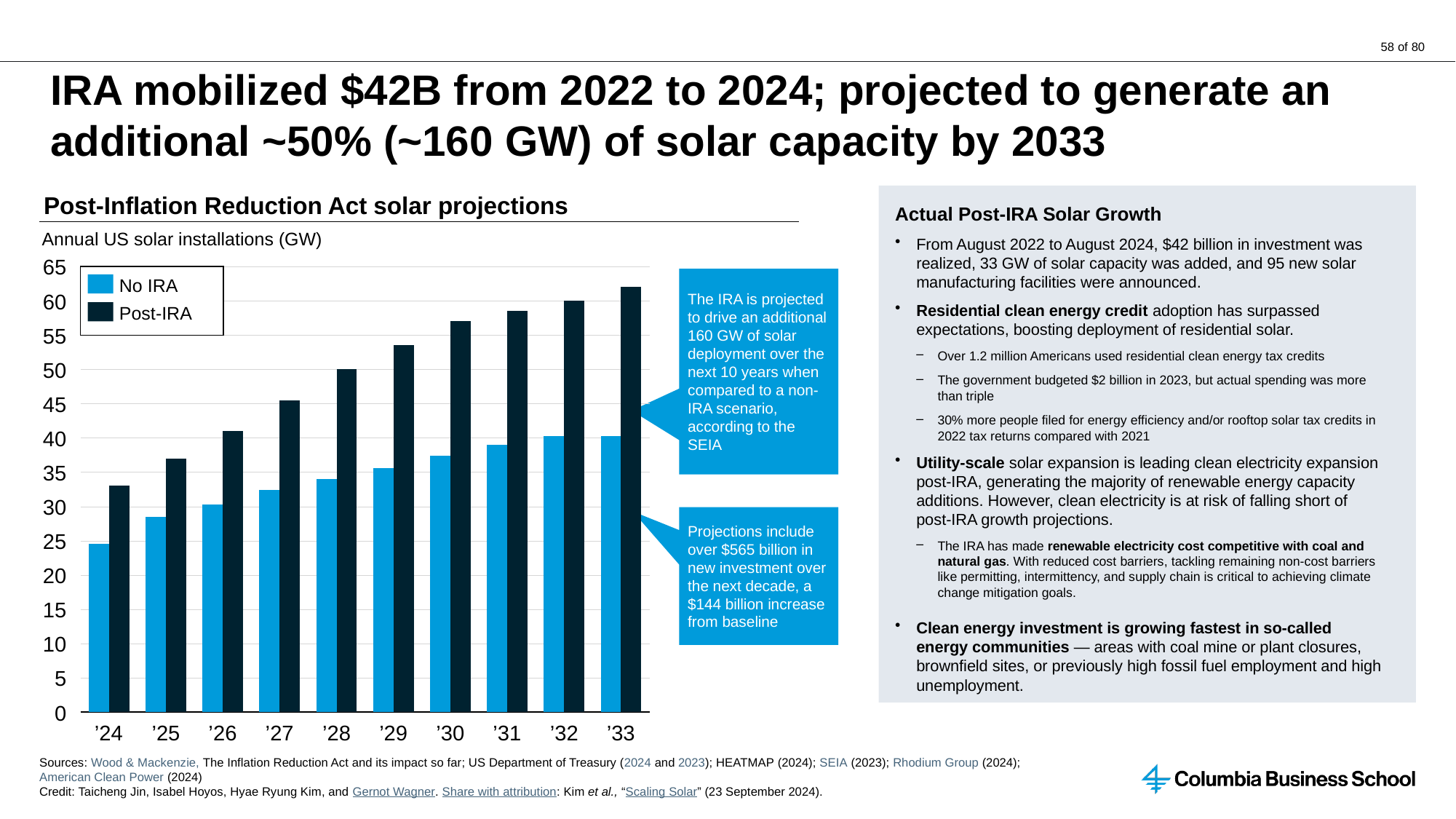
How many years are shown on the x axis of the chart? 10 How many series does the chart legend list? 2 Which year has the lowest No IRA value? '24 Is the No IRA value for '24 greater or less than 30? less What is the title of the chart? Post-Inflation Reduction Act solar projections Which year has the highest Post-IRA value? '33 In '29, which is larger: the No IRA value or the Post-IRA value? Post-IRA Which year has the lowest Post-IRA value? '24 Is the Post-IRA value for '30 greater or less than 55? greater Do the Post-IRA values rise or fall from '24 to '33? rise Is the Post-IRA value for '33 greater or less than 60? greater What kind of chart is shown on the slide? bar chart